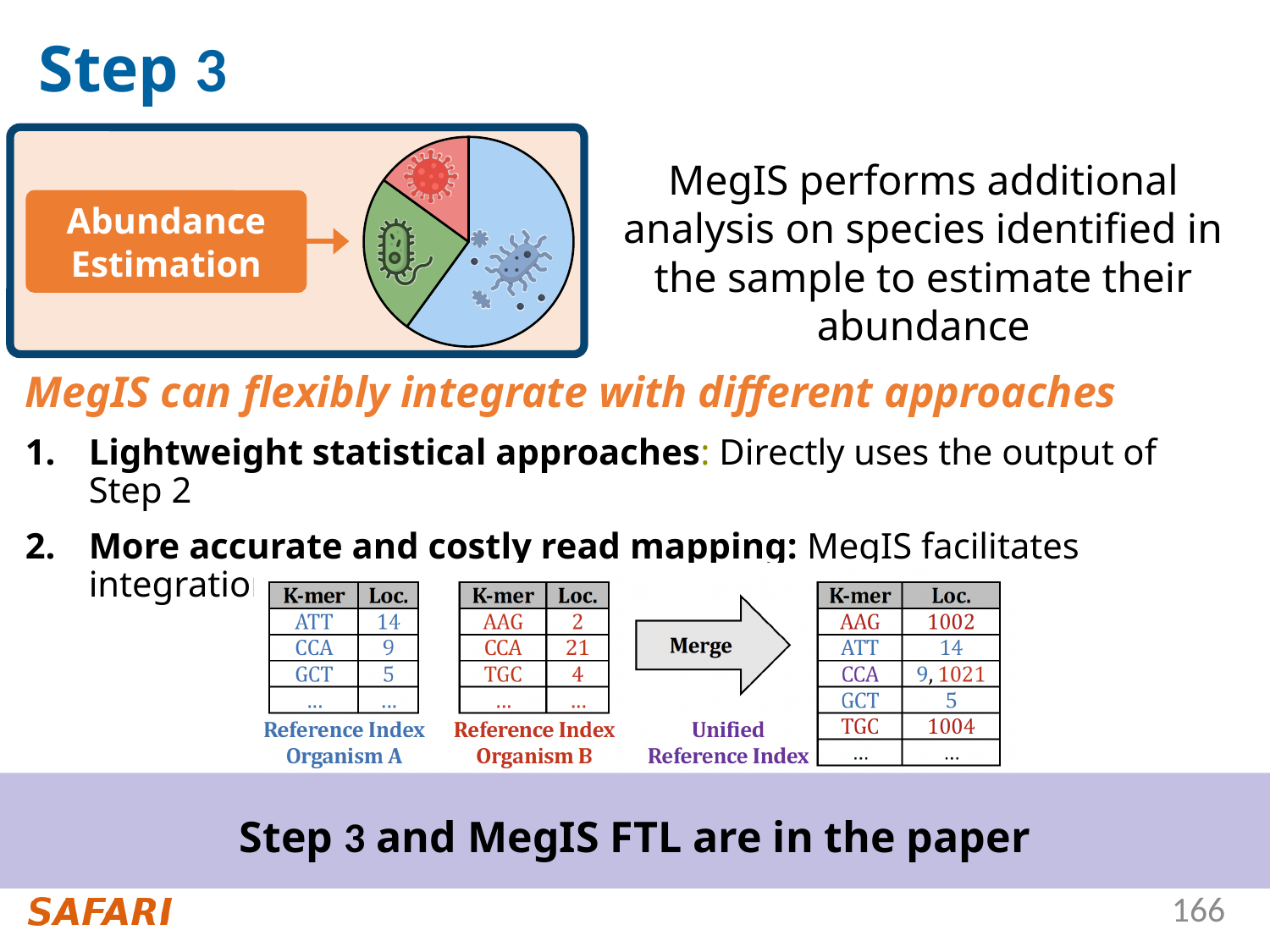
Which colour slice of the pie chart in the Abundance Estimation box is the smallest? red What kind of chart is shown inside the Abundance Estimation box? pie chart Is the green slice or the red slice of the pie chart larger? green How many slices does the pie chart in the Abundance Estimation box have? 3 What label is in the orange box pointing to the pie chart? Abundance Estimation Which colour slice of the pie chart in the Abundance Estimation box is the largest? blue